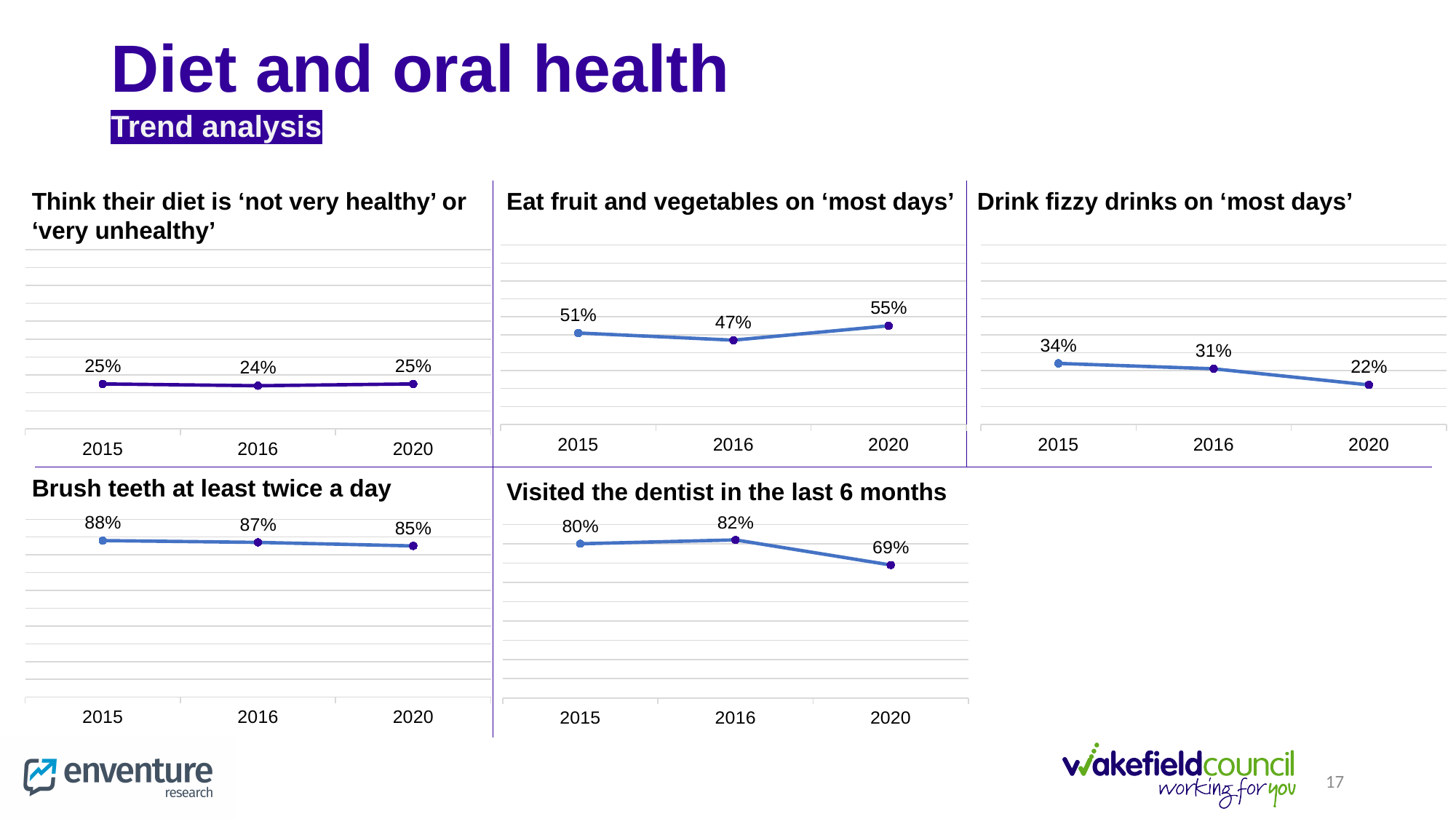
In the 'Drink fizzy drinks on ‘most days’' chart, what is the difference between the 2015 and 2020 values? 12% In the 'Visited the dentist in the last 6 months' chart, which is larger, the value for 2015 or 2016? 2016 In the 'Brush teeth at least twice a day' chart, what is the value for 2016? 87% In the 'Eat fruit and vegetables on ‘most days’' chart, what is the value for 2020? 55% In the 'Visited the dentist in the last 6 months' chart, which year has the lowest value? 2020 In the 'Think their diet is ‘not very healthy’ or ‘very unhealthy’' chart, what is the value for 2016? 24% What kind of chart is the 'Think their diet is ‘not very healthy’ or ‘very unhealthy’' chart? line chart In the 'Eat fruit and vegetables on ‘most days’' chart, which year has the highest value? 2020 In the 'Drink fizzy drinks on ‘most days’' chart, do the values rise or fall from 2015 to 2020? fall In the 'Drink fizzy drinks on ‘most days’' chart, what is the value for 2015? 34% How many charts are shown on the slide? 5 How many data points are plotted in the 'Brush teeth at least twice a day' chart? 3